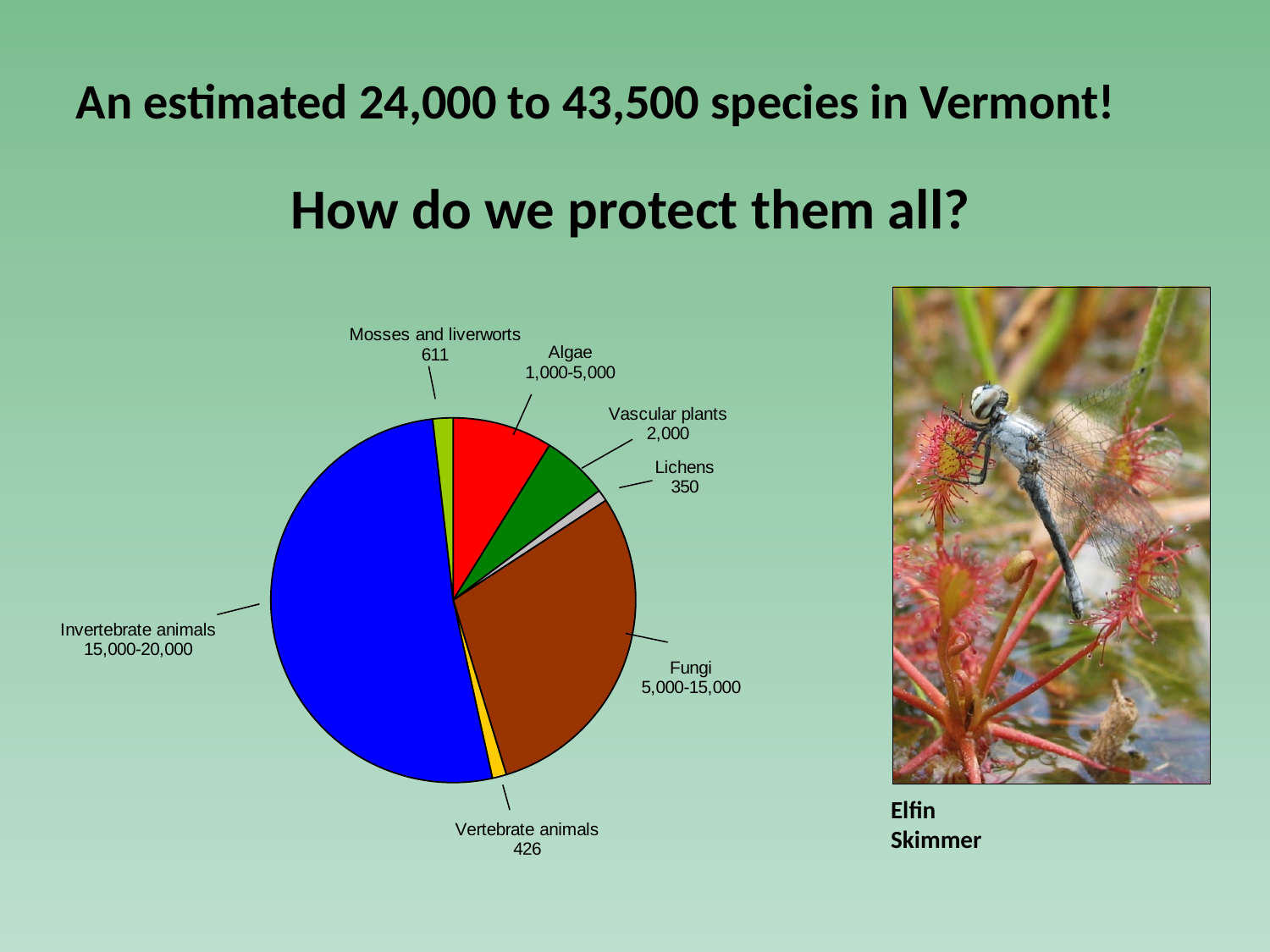
What value is shown for Mosses and liverworts? 611 What value is shown for Vertebrate animals? 426 What kind of chart is shown on the slide? pie chart Which colour is used for the Invertebrate animals slice? blue What value is shown for Vascular plants? 2,000 What is the difference between the values for Mosses and liverworts and Vertebrate animals? 185 Which category has the smallest slice of the pie? Lichens Which category has the largest slice of the pie? Invertebrate animals What value is shown for Lichens? 350 What range is shown for Invertebrate animals? 15,000-20,000 What range is shown for Fungi? 5,000-15,000 How many categories does the pie chart show? 7